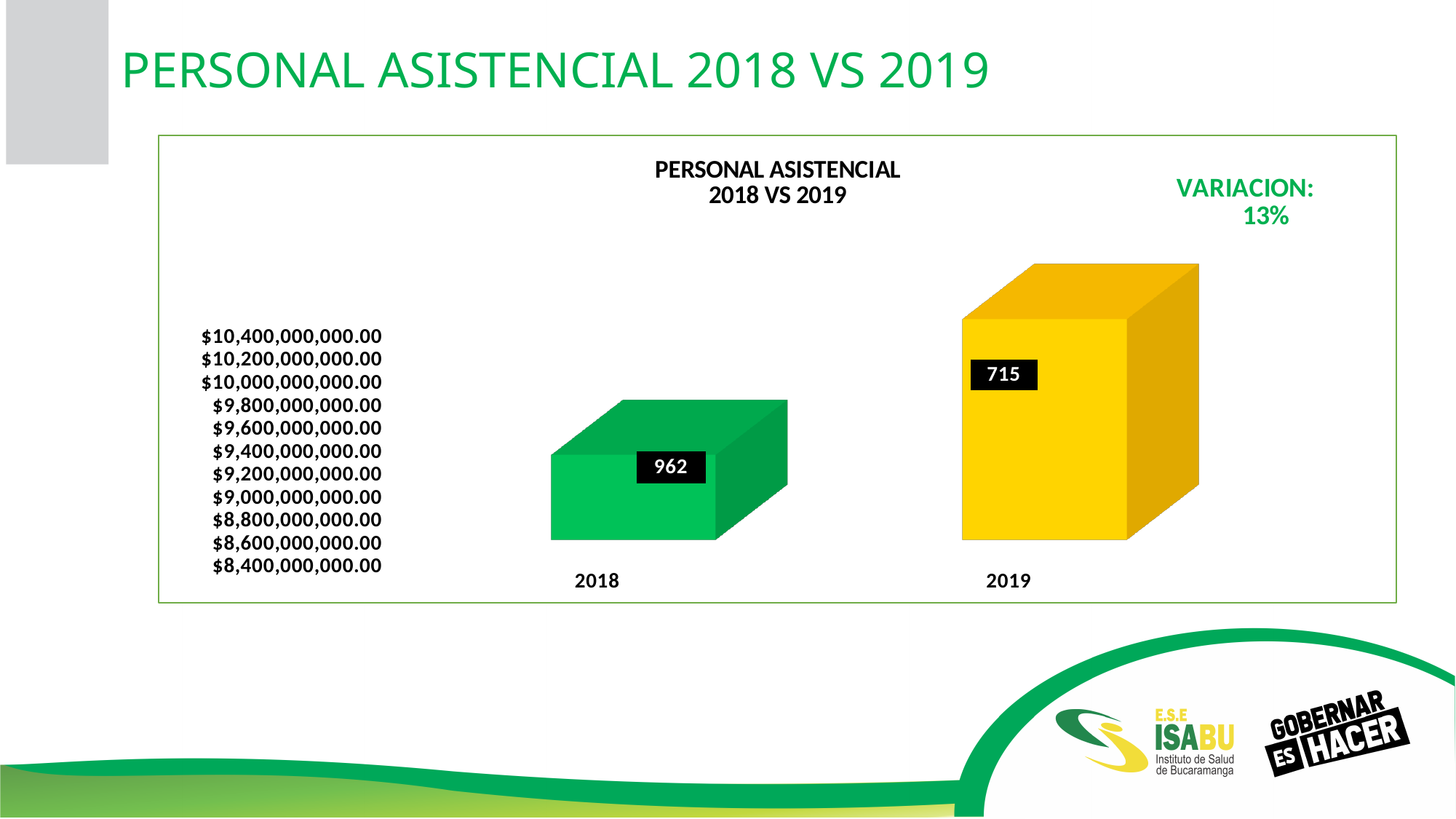
How many categories (years) are plotted on the chart? 2 What is the lowest value shown on the vertical axis of the chart? $8,400,000,000.00 What percentage variation is stated next to the chart? 13% Which year's bar carries the larger printed data label, 2018 or 2019? 2018 What is the data label shown on the 2018 bar? 962 What is the highest value shown on the vertical axis of the chart? $10,400,000,000.00 What kind of chart is shown on the slide? Bar chart What is the difference between the data labels for 2018 (962) and 2019 (715)? 247 What is the data label shown on the 2019 bar? 715 What is the title of the chart? PERSONAL ASISTENCIAL 2018 VS 2019